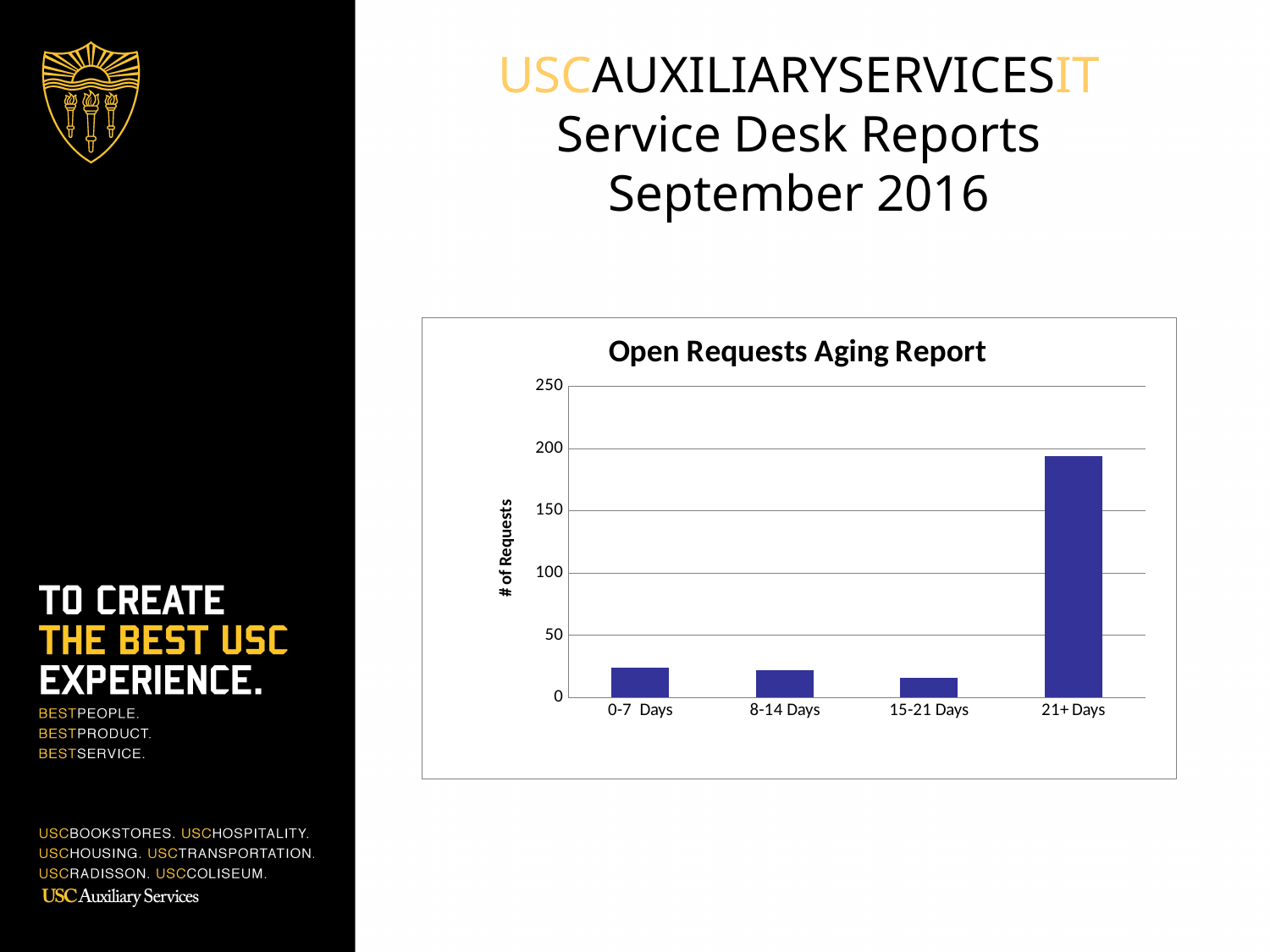
Is the value for 0-7 Days greater or less than 50? less Which age category has the highest number of open requests? 21+ Days How many age categories are shown on the x axis of the chart? 4 What type of chart is shown on the slide? bar chart Is the value for 15-21 Days greater or less than 50? less What is the label on the vertical axis of the chart? # of Requests Which has more open requests, 8-14 Days or 21+ Days? 21+ Days Is the value for 21+ Days greater or less than 150? greater Which age category has the lowest number of open requests? 15-21 Days Which has more open requests, 0-7 Days or 15-21 Days? 0-7 Days What is the title of the chart? Open Requests Aging Report